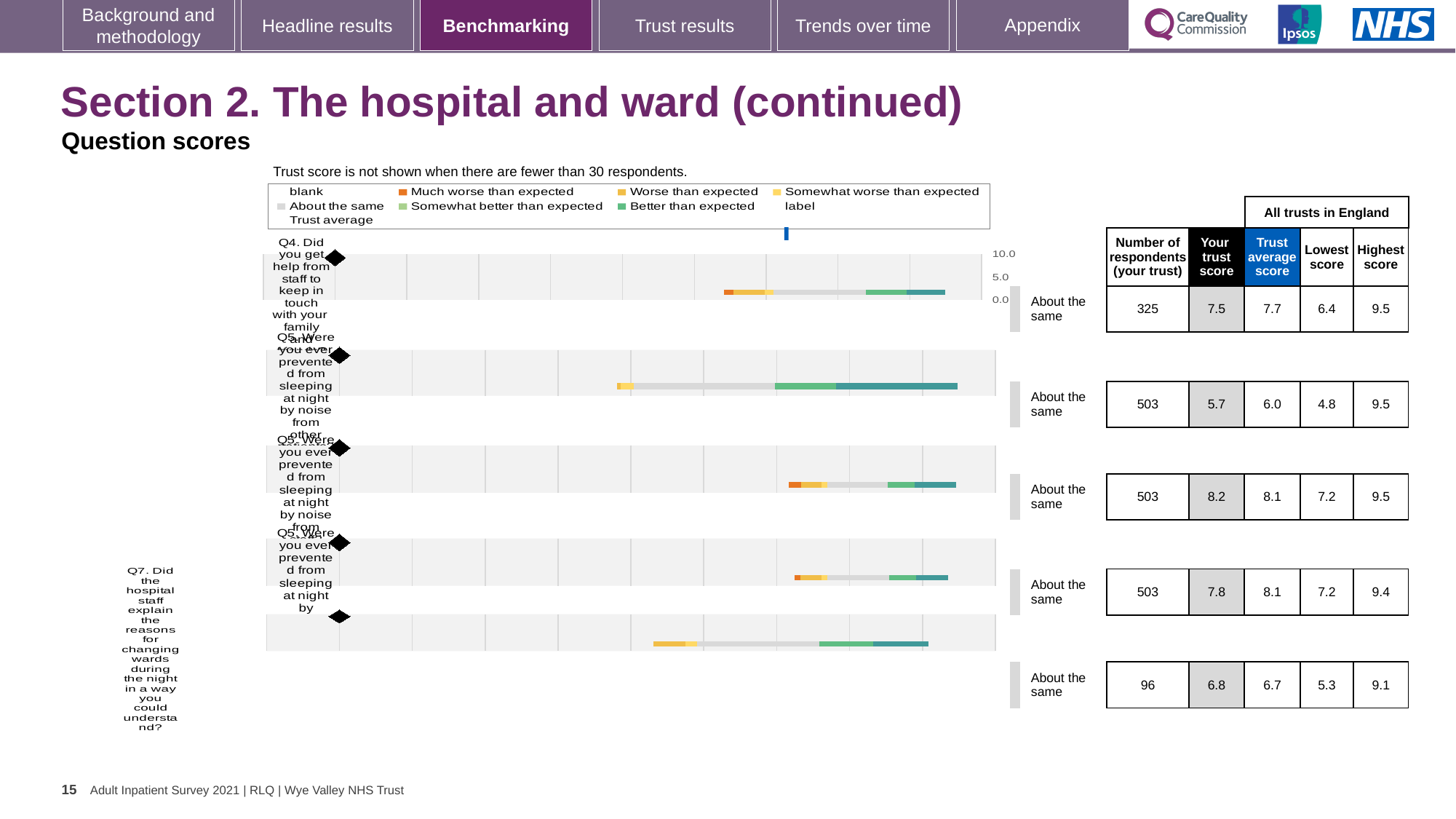
What is the lowest score across all trusts in England for Q7 (explaining reasons for changing wards during the night)? 5.3 What is the number of respondents (your trust) for Q4 (help from staff to keep in touch with family)? 325 What is the trust average score for Q4 (help from staff to keep in touch with family)? 7.7 What benchmark category is shown for every question row on this slide? About the same How many question rows are plotted in the chart? 5 What is your trust score for Q4 (help from staff to keep in touch with family)? 7.5 What is the difference between the highest score and the lowest score for Q4 (help from staff to keep in touch with family)? 3.1 How many respondents does the bottom row (Q7) show for your trust? 96 What kind of chart is used to show the question scores? Bar chart Which is larger for Q7 (explaining reasons for changing wards): your trust score or the trust average score? Your trust score Which row has the lowest 'Your trust score' in the table? The second row (5.7) What is your trust score for Q7 (explaining reasons for changing wards during the night)? 6.8